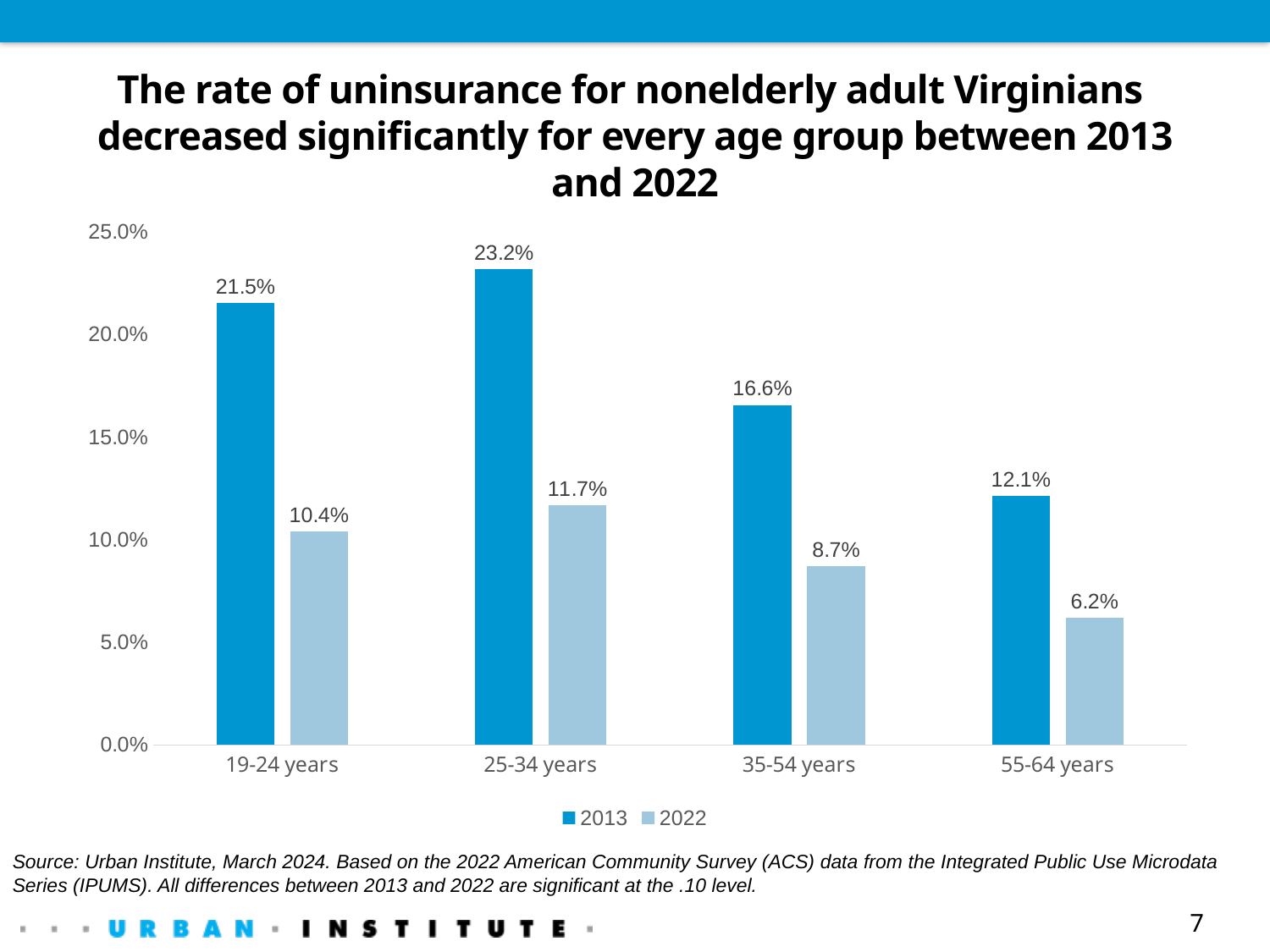
How many series does the legend list? 2 Is the 2013 value for 35-54 years greater or less than 15.0%? greater What was the uninsurance rate for 19-24 years in 2013? 21.5% Which age group had the lowest uninsurance rate in 2022? 55-64 years By how many percentage points did the uninsurance rate for 25-34 years fall between 2013 and 2022? 11.5 percentage points What is the difference between the 2013 rates for 19-24 years and 55-64 years? 9.4 percentage points What kind of chart is shown on the slide? Bar chart What was the uninsurance rate for 35-54 years in 2022? 8.7% How many age groups are shown on the chart? 4 Which age group had the highest uninsurance rate in 2013? 25-34 years What was the uninsurance rate for 55-64 years in 2022? 6.2% Which is larger: the 2022 rate for 19-24 years or the 2022 rate for 25-34 years? 25-34 years